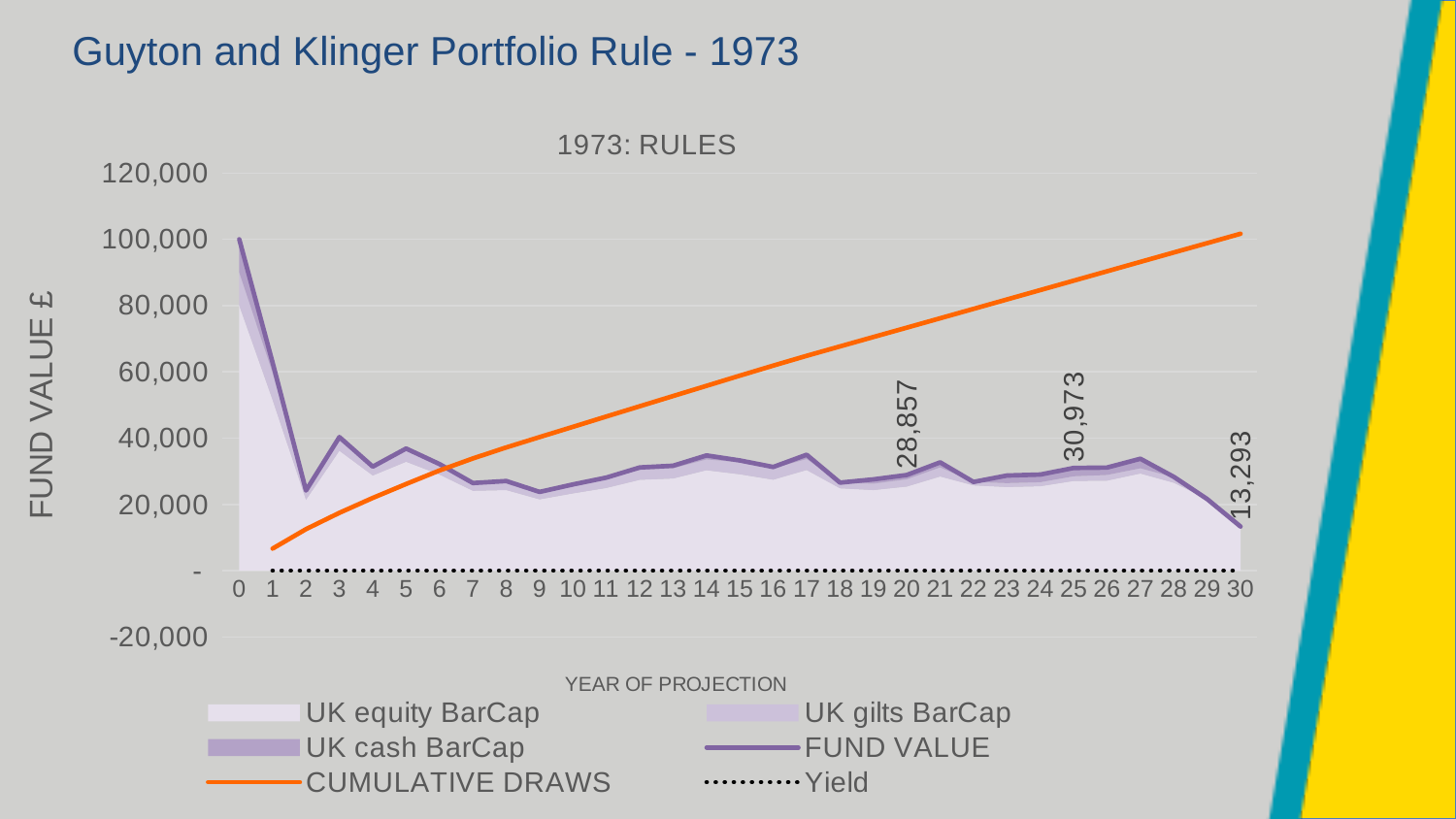
Does the CUMULATIVE DRAWS line rise or fall along the x axis? rise What is the title of the chart? 1973: RULES Is the FUND VALUE at year 0 greater or less than 80,000? greater What is the FUND VALUE at year 25 of the projection? 30,973 Of the three labelled FUND VALUE points (years 20, 25 and 30), which year has the lowest value? 30 What is the difference between the FUND VALUE at year 25 and at year 20? 2,116 Is the CUMULATIVE DRAWS value at year 30 greater or less than 80,000? greater Of the three labelled FUND VALUE points (years 20, 25 and 30), which year has the highest value? 25 Is the FUND VALUE at year 25 or at year 30 larger? year 25 What is the FUND VALUE at year 20 of the projection? 28,857 How many series does the legend list? 6 What is the FUND VALUE at year 30 of the projection? 13,293